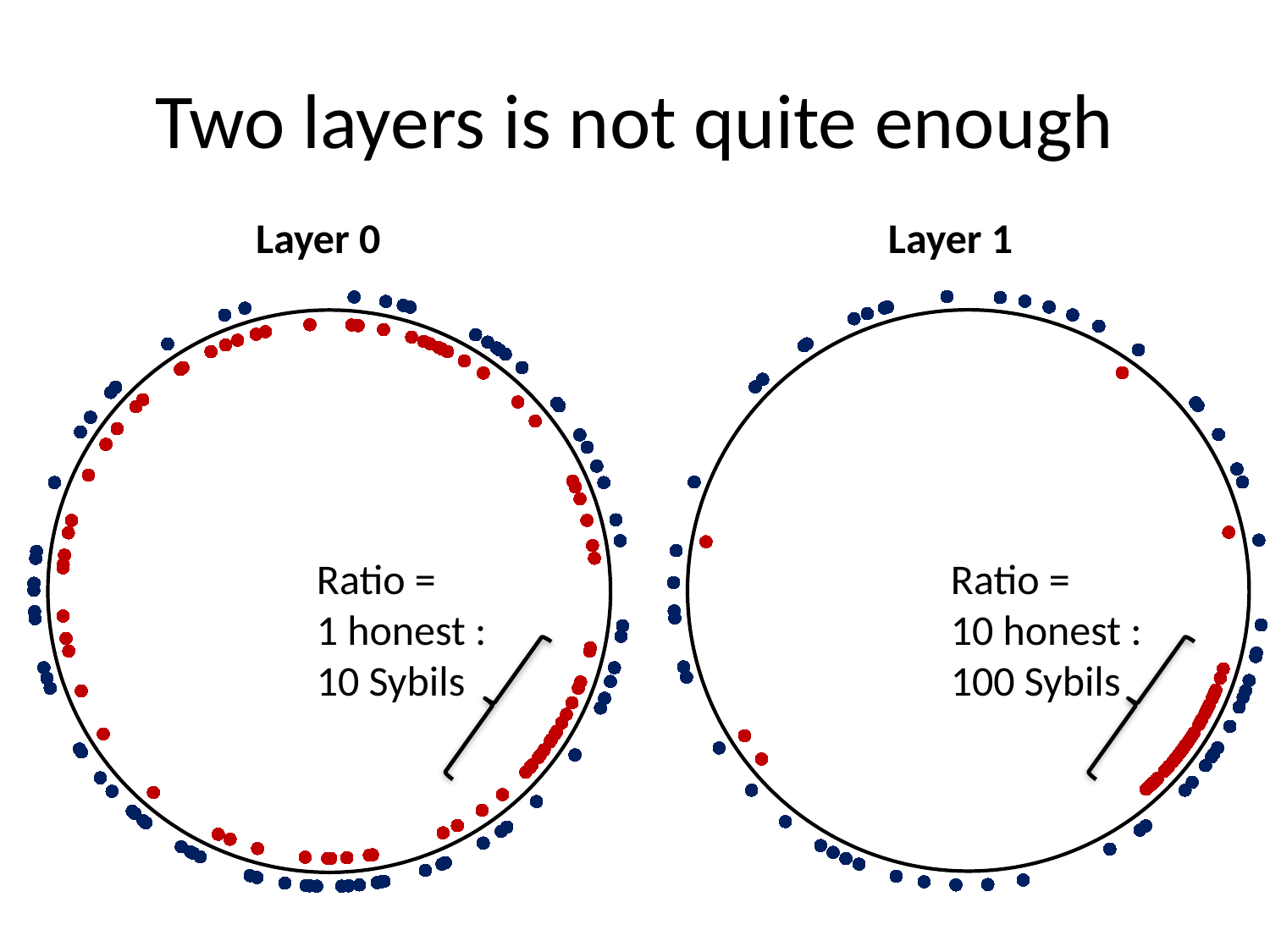
What is the label above the left diagram? Layer 0 How many honest nodes are stated in the Layer 1 ratio? 10 In the Layer 0 diagram, what ratio is stated? 1 honest : 10 Sybils What is the difference between the number of honest nodes stated for Layer 1 and for Layer 0? 9 What is the title of the slide? Two layers is not quite enough How many circular diagrams are shown on the slide? 2 Which layer's diagram states the ratio 10 honest : 100 Sybils? Layer 1 In the Layer 1 diagram, what ratio is stated? 10 honest : 100 Sybils Which layer's stated ratio has more Sybils, Layer 0 or Layer 1? Layer 1 How many Sybils are stated in the Layer 0 ratio? 10 What is the difference between the number of Sybils stated for Layer 1 and for Layer 0? 90